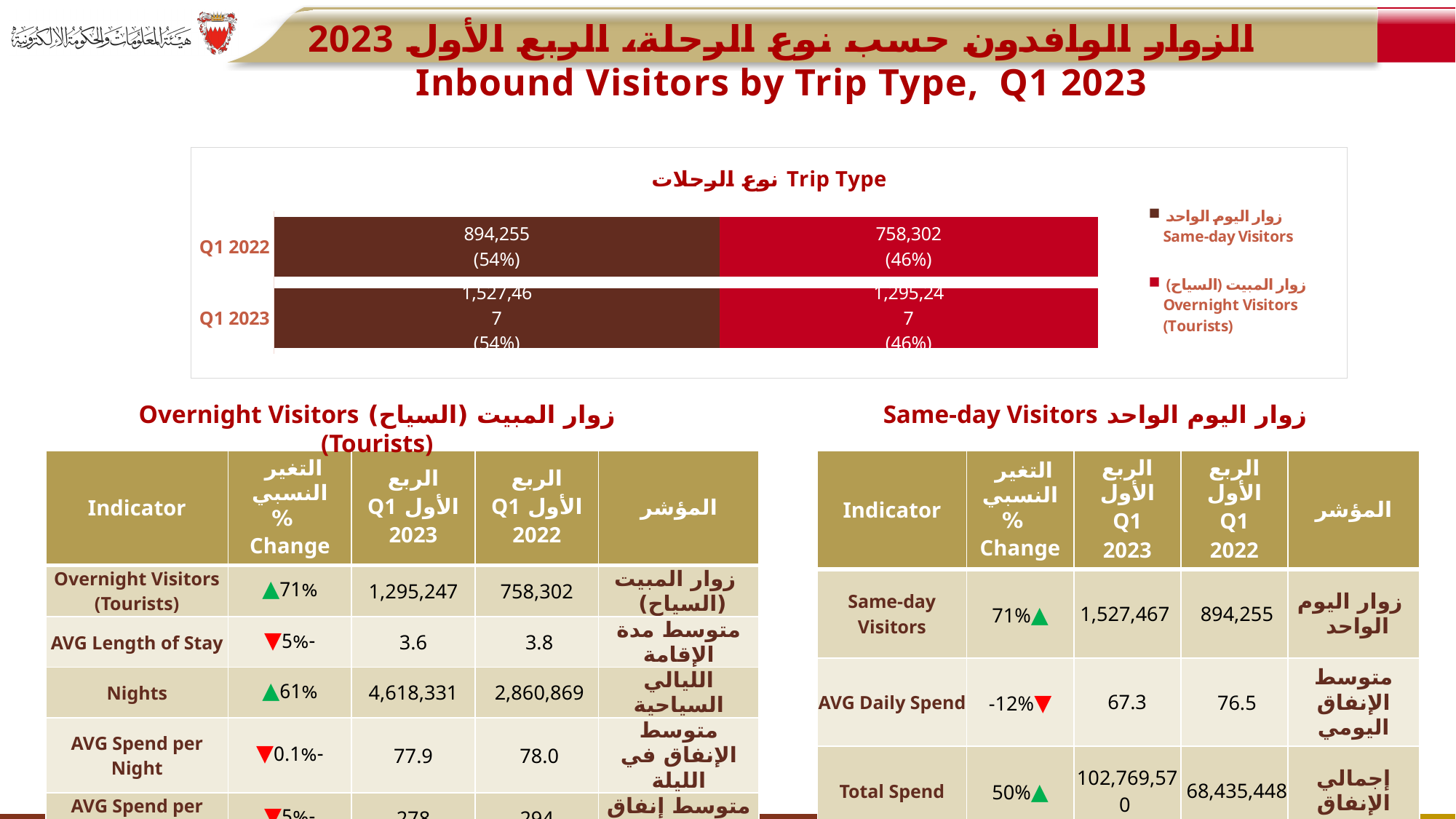
How many series does the legend of the Trip Type chart list? 2 In the Trip Type chart, what percentage share do Overnight Visitors (Tourists) make up in Q1 2022? 46% In the Trip Type chart, by how much did Same-day Visitors increase from Q1 2022 to Q1 2023? 633,212 In the Trip Type chart, what is the number of Same-day Visitors in Q1 2022? 894,255 How many periods (bars) are shown in the Trip Type chart? 2 In the Trip Type chart, what is the total number of inbound visitors in Q1 2023? 2,822,714 In the Trip Type chart, what is the number of Same-day Visitors in Q1 2023? 1,527,467 In the Trip Type chart, what is the number of Overnight Visitors (Tourists) in Q1 2023? 1,295,247 What type of chart is the Trip Type chart? Stacked bar chart In the Trip Type chart, which series is larger in Q1 2023: Same-day Visitors or Overnight Visitors (Tourists)? Same-day Visitors In the Trip Type chart, what is the total number of inbound visitors in Q1 2022? 1,652,557 In the Trip Type chart, what percentage share do Same-day Visitors make up in Q1 2023? 54%